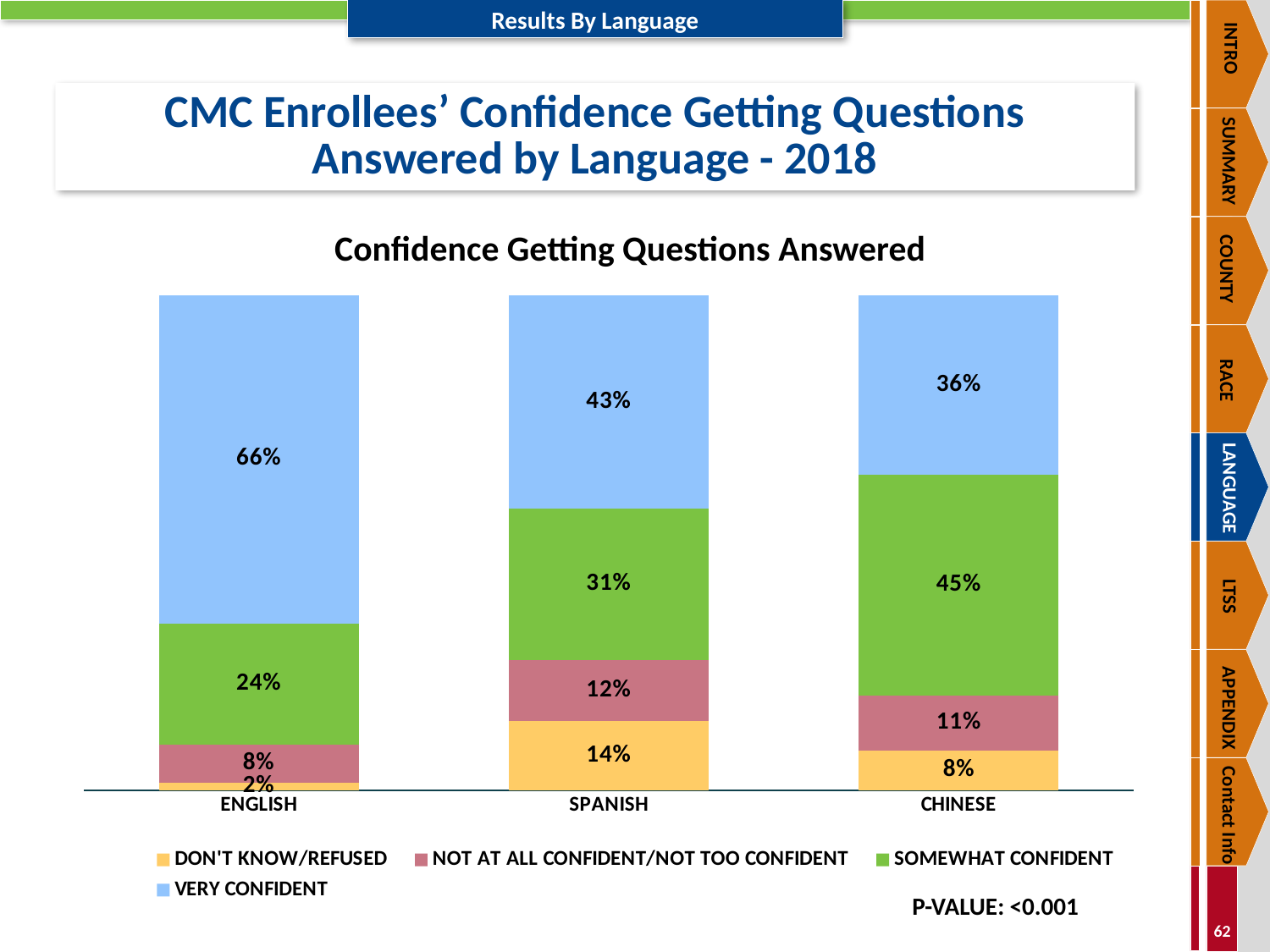
What percentage of Chinese-speaking enrollees were somewhat confident? 45% What percentage of Spanish-speaking enrollees answered don't know/refused? 14% What is the difference between the very confident share for English and for Chinese? 30% What kind of chart is shown? Stacked bar chart How many series does the legend list? 4 How many language groups are shown on the x axis? 3 What p-value is shown below the chart? <0.001 Which language group has the highest share of very confident enrollees? English What percentage of English-speaking enrollees were very confident? 66% Is the somewhat confident share larger for Spanish or for Chinese? Chinese What is the combined share of somewhat confident and very confident for Spanish? 74% Which language group has the lowest share of don't know/refused responses? English